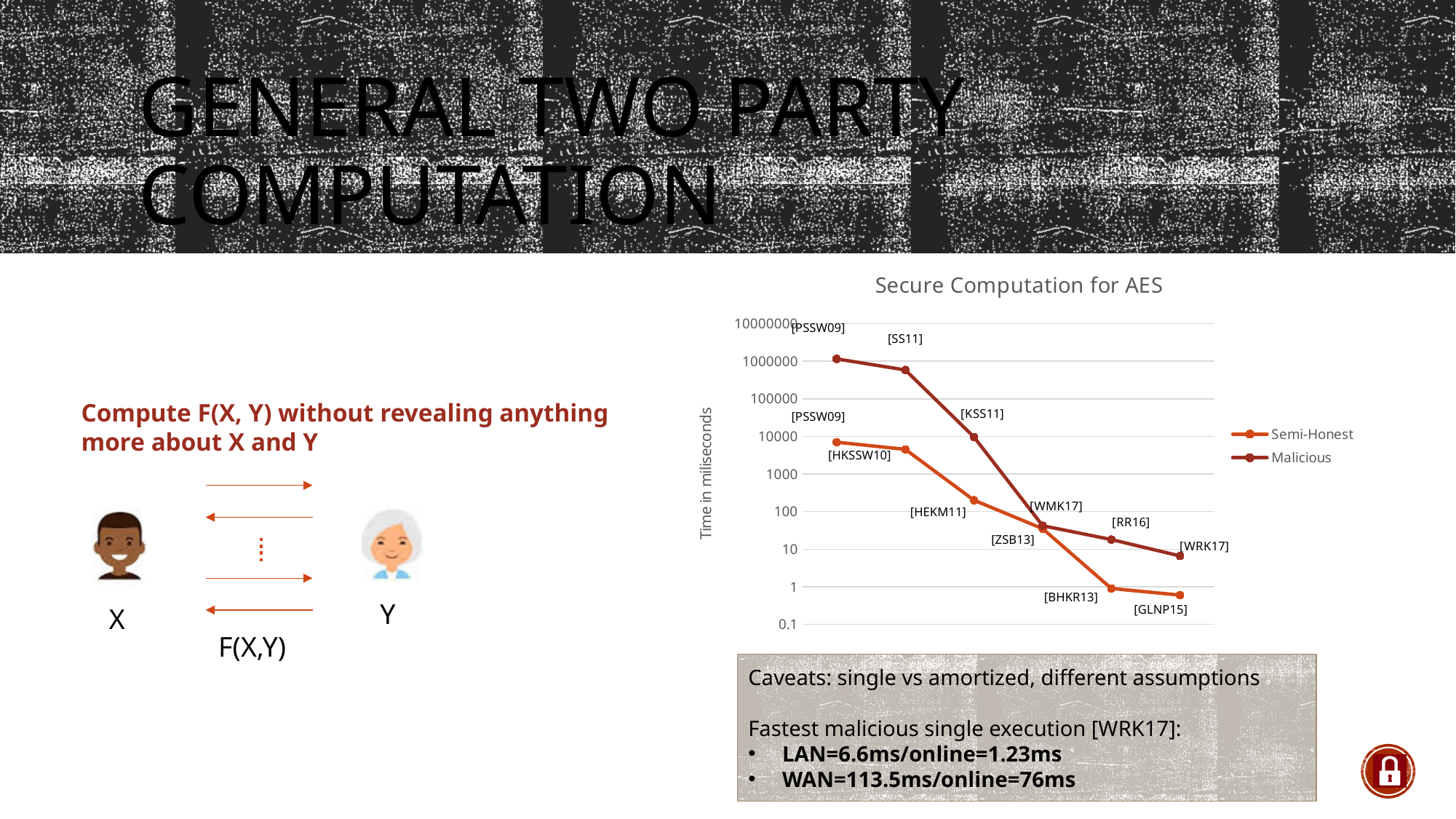
In the 'Secure Computation for AES' chart, is the Malicious value for [SS11] greater or less than 100000? greater In the 'Secure Computation for AES' chart, which is larger at [PSSW09]: the Malicious value or the Semi-Honest value? Malicious What are the two series named in the legend of the 'Secure Computation for AES' chart? Semi-Honest and Malicious In the 'Secure Computation for AES' chart, is the Malicious value for [WRK17] greater or less than 10? less What kind of chart is 'Secure Computation for AES'? line chart How many labelled points are on the Malicious line in the 'Secure Computation for AES' chart? 6 What is the y-axis label of the 'Secure Computation for AES' chart? Time in miliseconds How many series does the legend of the 'Secure Computation for AES' chart list? 2 How many labelled points are on the Semi-Honest line in the 'Secure Computation for AES' chart? 6 In the 'Secure Computation for AES' chart, which labelled point on the Semi-Honest line has the lowest value? [GLNP15] In the 'Secure Computation for AES' chart, do the values of the Malicious line rise or fall from left to right? fall In the 'Secure Computation for AES' chart, which labelled point on the Malicious line has the highest value? [PSSW09]